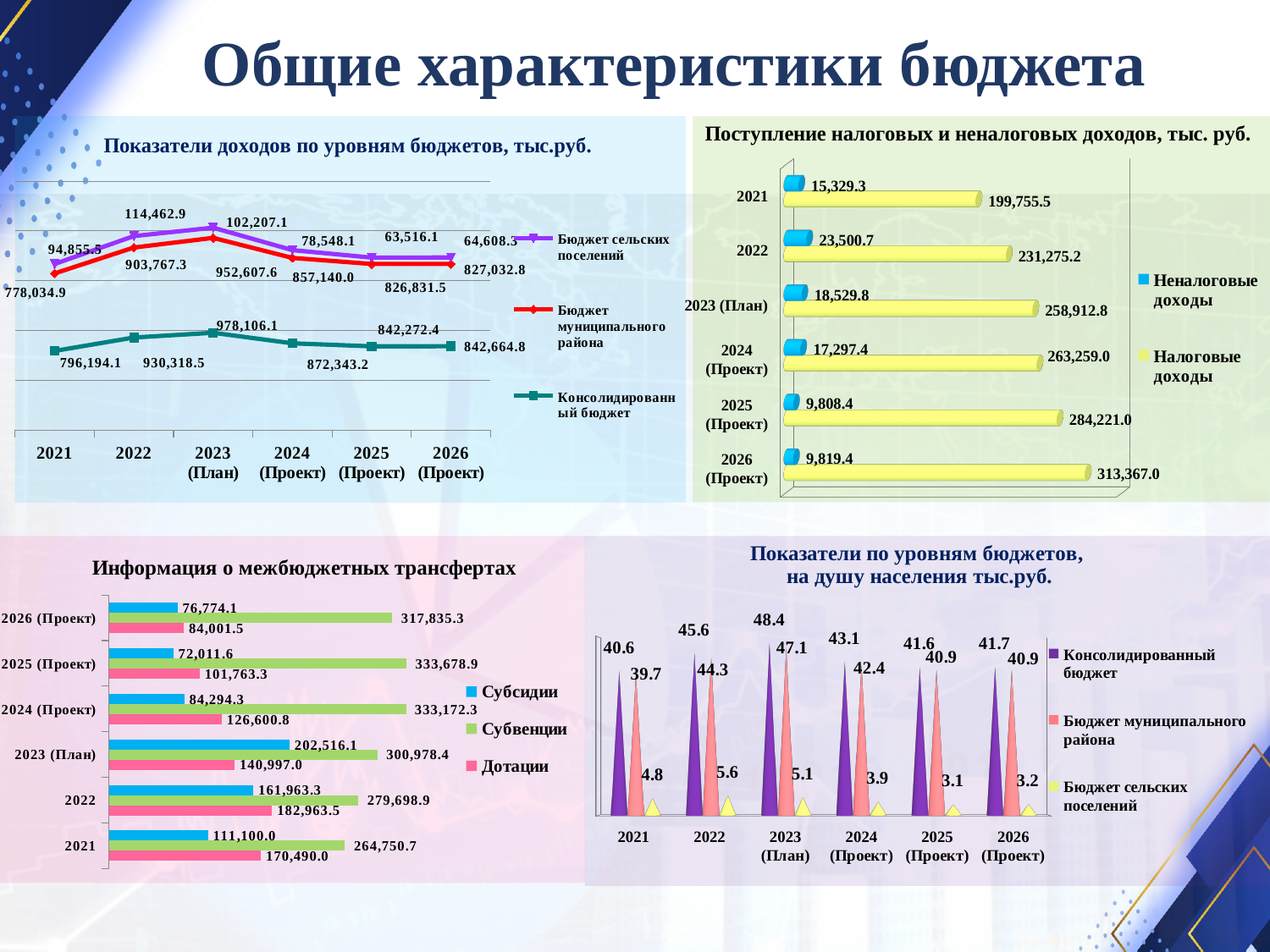
In the chart 'Показатели доходов по уровням бюджетов, тыс.руб.', what is the value of Бюджет сельских поселений for 2022? 114,462.9 In the chart 'Показатели по уровням бюджетов, на душу населения тыс.руб.', what is the value of Бюджет сельских поселений for 2022? 5.6 In the chart 'Поступление налоговых и неналоговых доходов, тыс. руб.', what is the difference between Налоговые доходы in 2022 and in 2021? 31,519.7 How many series does the legend of the chart 'Информация о межбюджетных трансфертах' list? 3 In the chart 'Показатели по уровням бюджетов, на душу населения тыс.руб.', what is the difference between Консолидированный бюджет and Бюджет муниципального района in 2023 (План)? 1.3 In the chart 'Информация о межбюджетных трансфертах', which is larger for 2022: Субсидии or Дотации? Дотации In the chart 'Поступление налоговых и неналоговых доходов, тыс. руб.', which year has the highest value of Неналоговые доходы? 2022 In the chart 'Поступление налоговых и неналоговых доходов, тыс. руб.', what is the value of Налоговые доходы for 2026 (Проект)? 313,367.0 In the chart 'Информация о межбюджетных трансфертах', which year has the lowest value of Субсидии? 2025 (Проект) In the chart 'Информация о межбюджетных трансфертах', what is the value of Субвенции for 2025 (Проект)? 333,678.9 What kind of chart is 'Показатели доходов по уровням бюджетов, тыс.руб.'? Line chart In the chart 'Показатели доходов по уровням бюджетов, тыс.руб.', in which year does Консолидированный бюджет reach its highest value? 2023 (План)